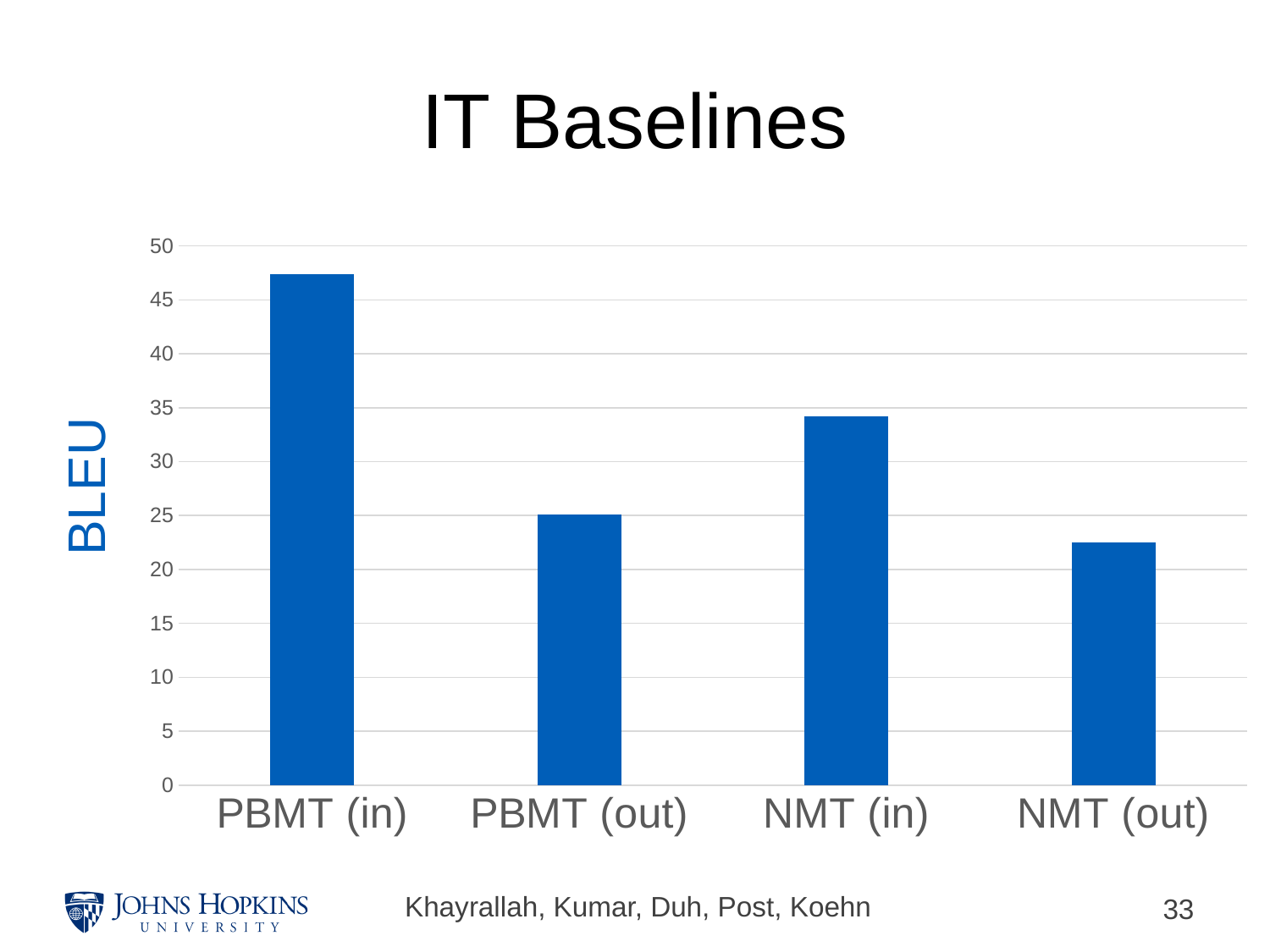
Is the BLEU value for NMT (out) greater or less than 20? greater Which has a higher BLEU score, PBMT (in) or NMT (in)? PBMT (in) What is the title of the chart? IT Baselines Is the BLEU value for PBMT (in) greater or less than 45? greater Is the BLEU value for NMT (out) greater or less than 25? less Which has a higher BLEU score, PBMT (out) or NMT (in)? NMT (in) Which category has the lowest BLEU score? NMT (out) What kind of chart is shown on the slide? bar chart Which category has the highest BLEU score? PBMT (in) How many categories are plotted on the chart? 4